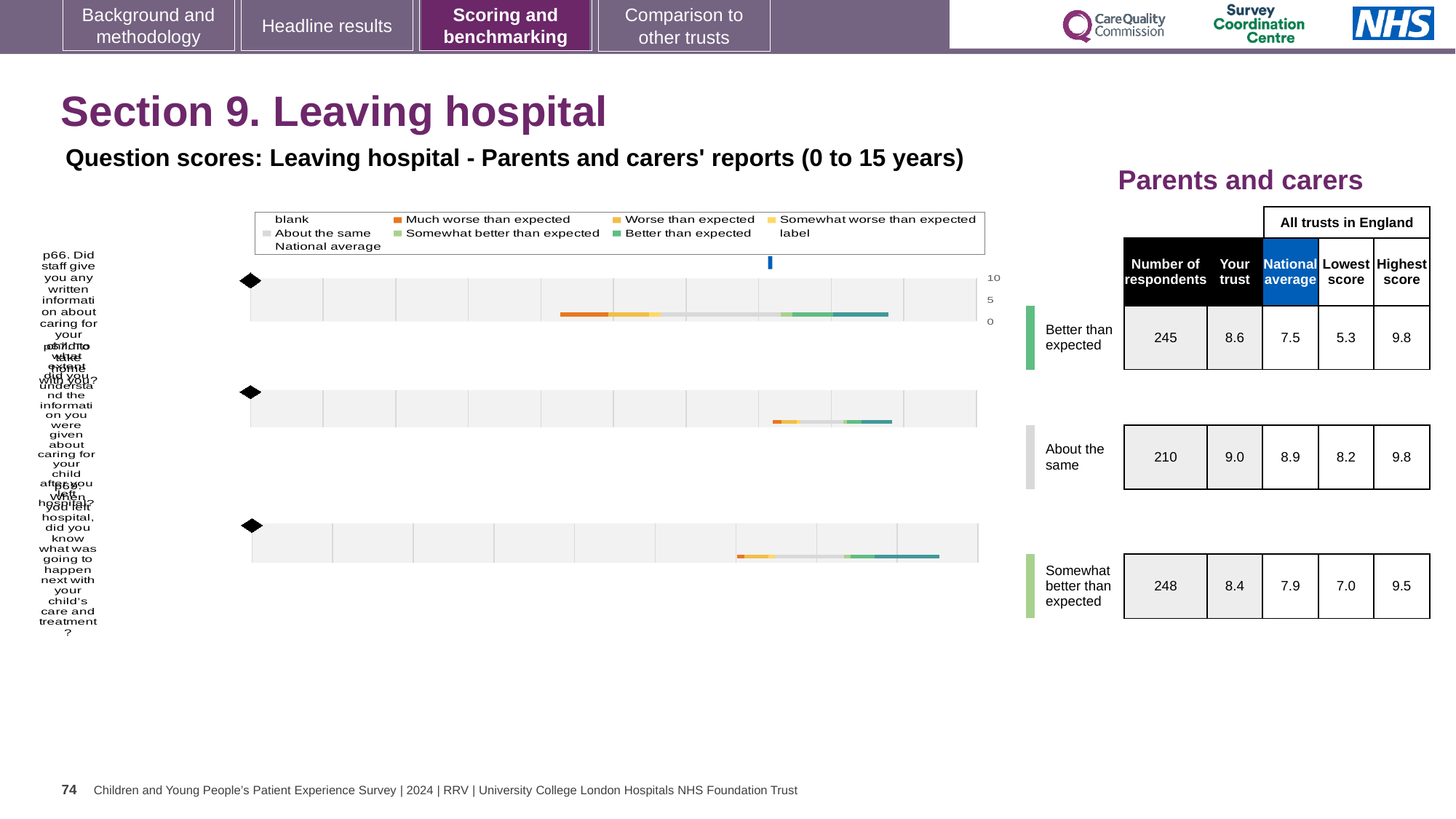
Which has the larger 'Your trust' score: the top row (Better than expected) or the bottom row (Somewhat better than expected)? Better than expected How many entries does the chart legend list? 9 For the middle row (About the same), what is the difference between the highest score and the lowest score? 1.6 In the table beside the chart, how many respondents are recorded for the bottom row (Somewhat better than expected)? 248 Which row in the table has the lowest value in the 'Lowest score' column? Better than expected In the table beside the chart, what is the 'Your trust' score for the top row (Better than expected)? 8.6 What kind of chart is shown on the slide? bar chart How many horizontal bars (question rows) does the chart contain? 3 For the top row (Better than expected), what is the difference between the 'Your trust' score and the national average? 1.1 What is the title of the chart? Question scores: Leaving hospital - Parents and carers' reports (0 to 15 years) In the table beside the chart, what is the national average for the middle row (About the same)? 8.9 Which row in the table has the highest 'Your trust' score? About the same